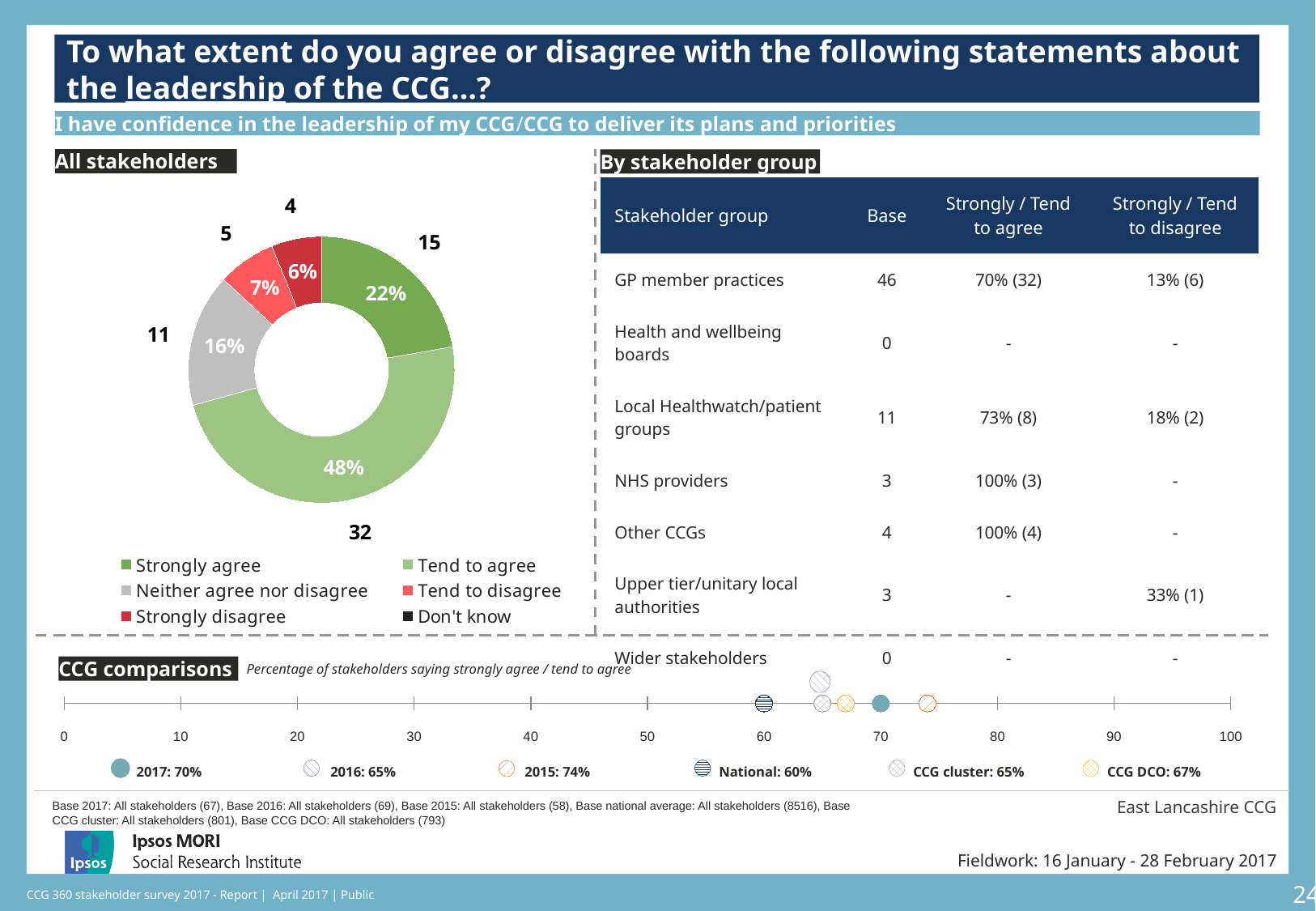
In the 'All stakeholders' chart, how many percentage points higher is 'Tend to agree' than 'Strongly agree'? 26 percentage points In the 'All stakeholders' chart, how many respondents said 'Neither agree nor disagree'? 11 In the 'All stakeholders' chart, which is larger: 'Tend to disagree' or 'Strongly disagree'? Tend to disagree In the 'All stakeholders' chart, what percentage of stakeholders said 'Strongly agree'? 22% In the 'All stakeholders' chart, which response has the largest share? Tend to agree What kind of chart is the 'All stakeholders' chart? pie chart (donut) How many entries does the legend of the 'All stakeholders' chart list? 6 In the 'CCG comparisons' chart, which comparison point has the highest value? 2015: 74% In the 'CCG comparisons' chart, how many percentage points higher is 2017 than 2016? 5 percentage points In the 'All stakeholders' chart, which labelled response has the smallest share? Strongly disagree In the 'CCG comparisons' chart, what is the 2017 percentage of stakeholders saying strongly agree / tend to agree? 70% In the 'All stakeholders' chart, what percentage of stakeholders said 'Tend to agree'? 48%